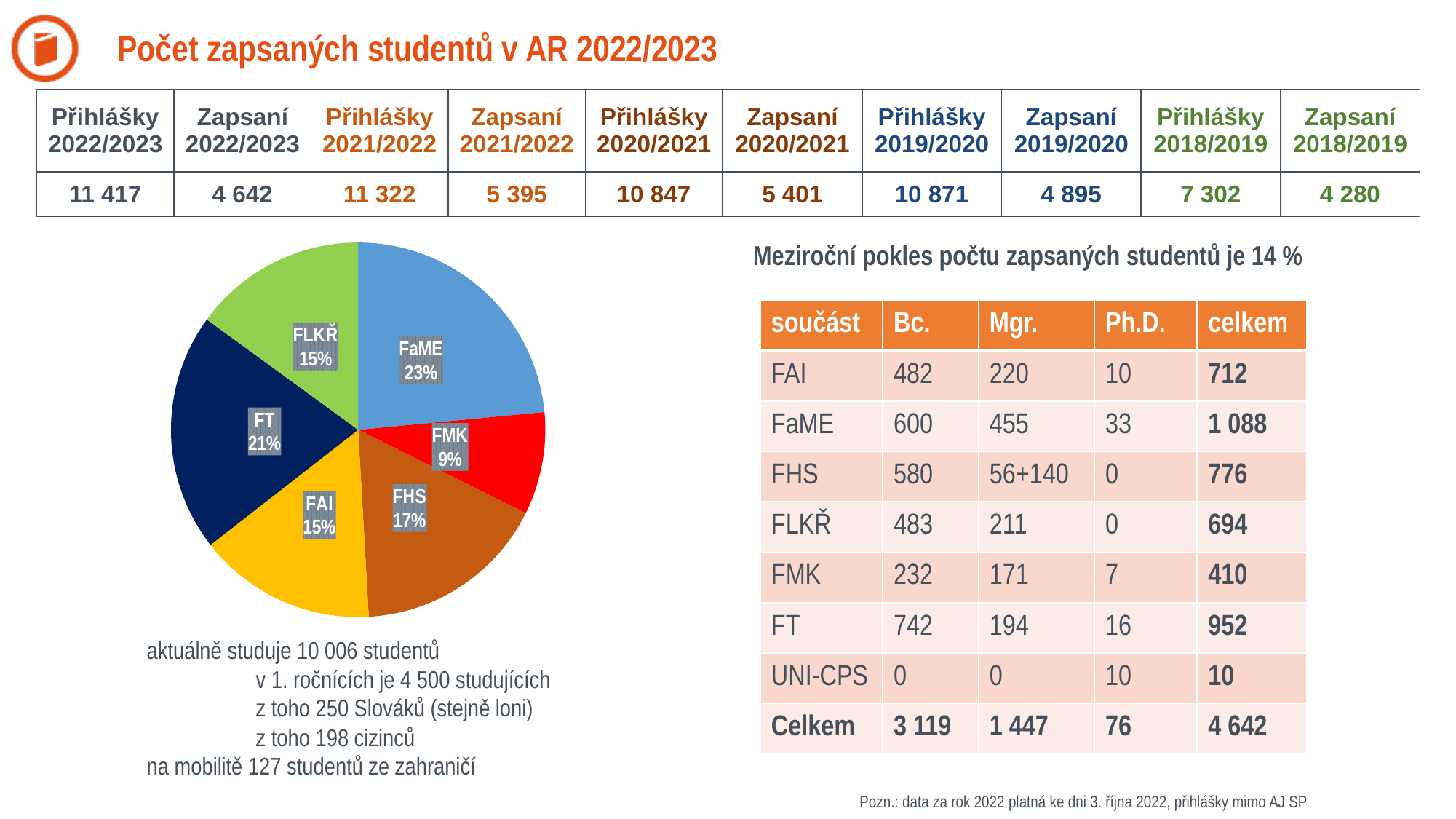
What share of the pie chart does FMK have? 9% What colour is the FAI slice in the pie chart? yellow What share of the pie chart does FaME have? 23% What share of the pie chart does FHS have? 17% Which slice is larger in the pie chart, FT or FHS? FT What kind of chart is shown on the slide? pie chart What is the difference in percentage points between the FaME and FT slices? 2 Which two slices of the pie chart have the same share of 15%? FAI and FLKŘ How many slices does the pie chart have? 6 Which slice of the pie chart is the smallest? FMK Which slice of the pie chart is the largest? FaME